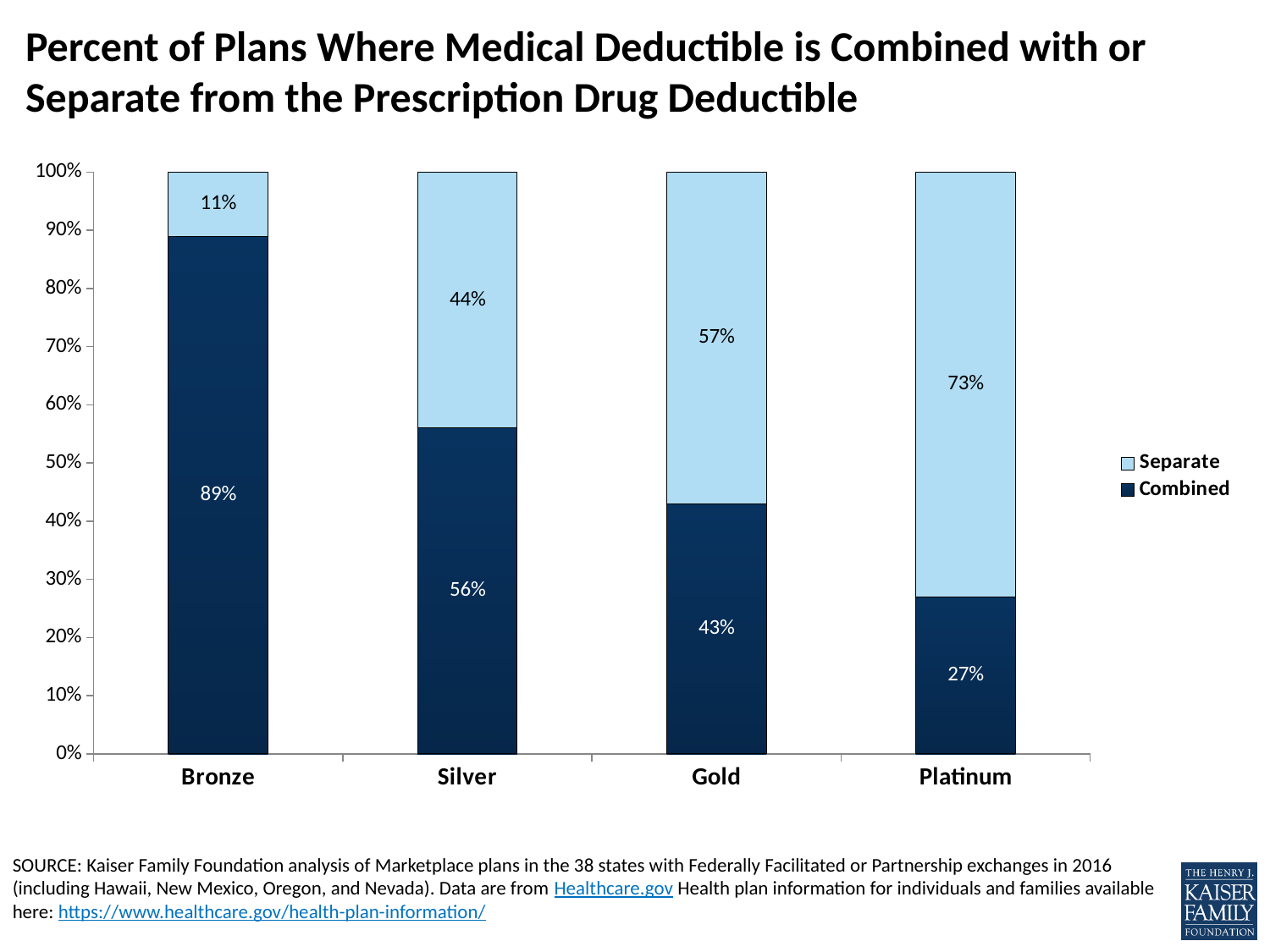
How many plan tiers are shown on the x axis? 4 Is the Separate percentage larger for Gold or for Silver? Gold What percent of Platinum plans have a Separate deductible? 73% What is the Separate value for Silver plans? 44% What is the Combined value for Gold plans? 43% What kind of chart is shown on the slide? Stacked bar chart Does the Combined percentage rise or fall from Bronze to Platinum? Fall What percent of Bronze plans have a Combined deductible? 89% Which plan tier has the highest Combined percentage? Bronze What is the difference between the Combined percentages for Bronze and Platinum? 62% How many series does the legend list? 2 Which plan tier has the lowest Separate percentage? Bronze